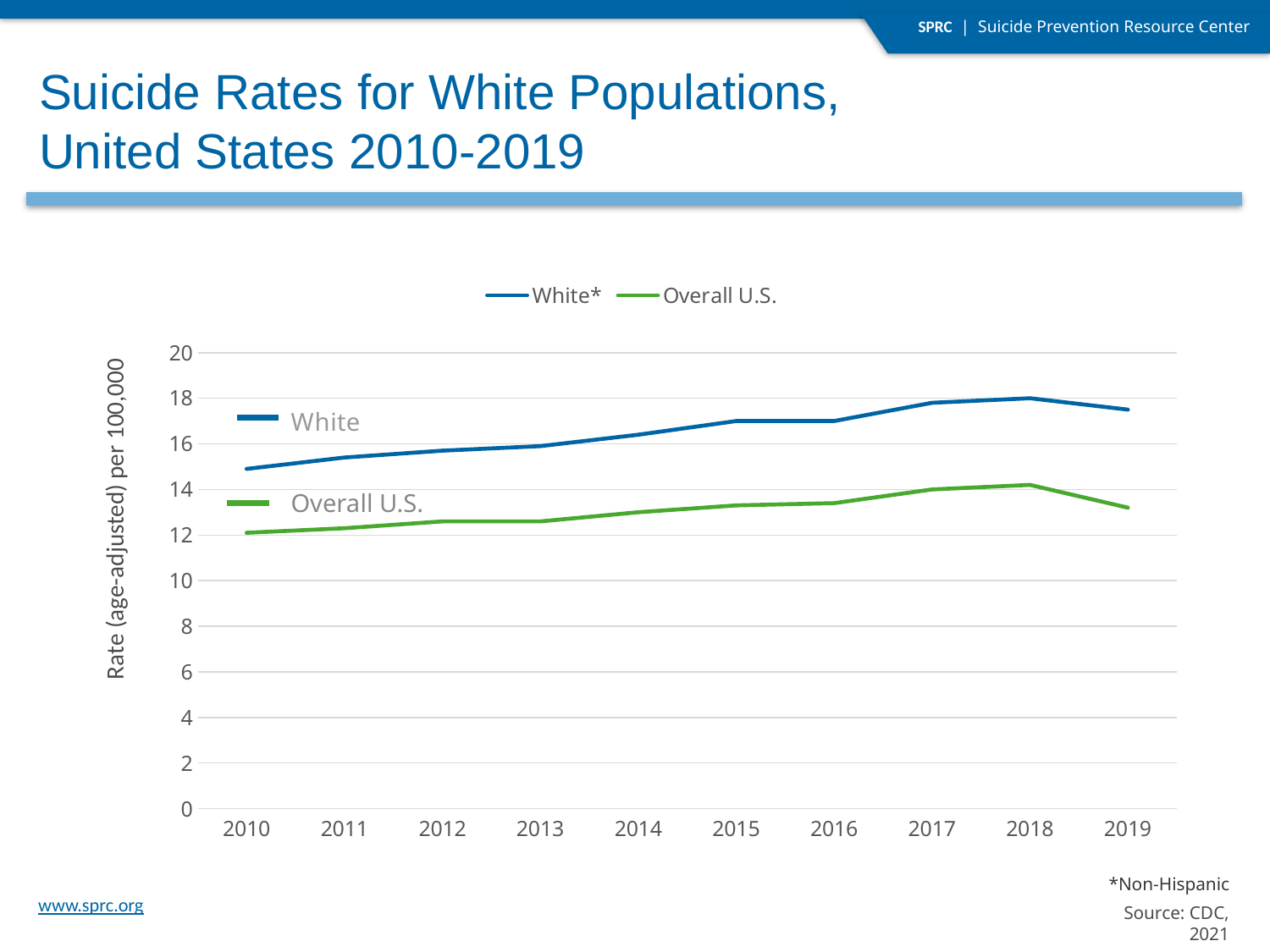
Is the White* rate in 2010 greater or less than 16? less Does the Overall U.S. rate generally rise or fall from 2010 to 2018? rise What kind of chart is shown on the slide? Line chart In which year is the Overall U.S. suicide rate lowest? 2010 Which series has the higher rate in 2019, White* or Overall U.S.? White* Is the White* rate in 2015 greater or less than 16? greater How many years are plotted along the x axis? 10 How many series does the legend list? 2 What is the label on the y axis? Rate (age-adjusted) per 100,000 In which year is the White* suicide rate lowest? 2010 Is the Overall U.S. rate in 2019 greater or less than 14? less In which year is the White* suicide rate highest? 2018